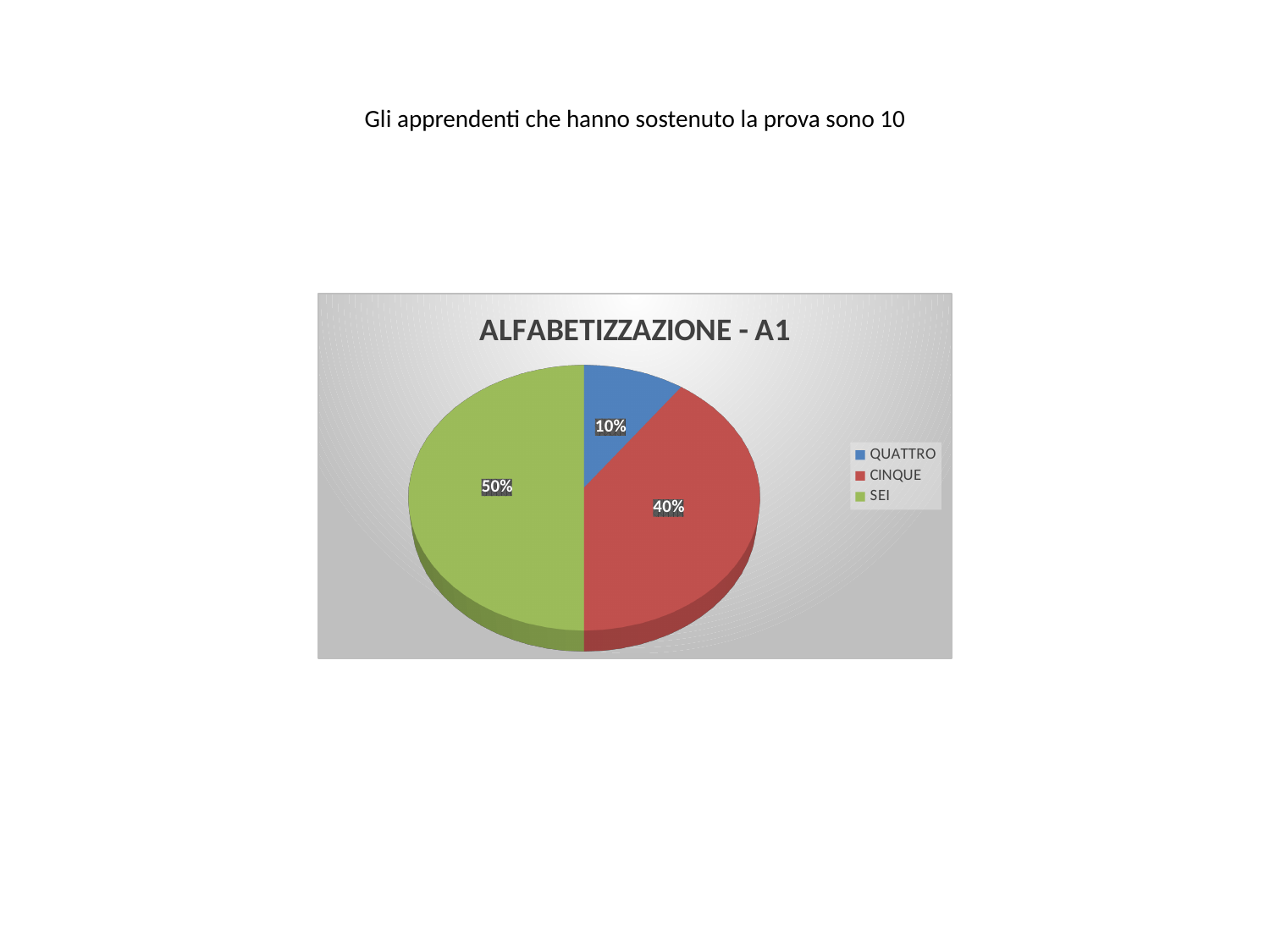
Which colour represents the CINQUE category in the legend? red What is the title of the chart? ALFABETIZZAZIONE - A1 How many categories does the pie chart have? 3 What share of the pie does the CINQUE slice represent? 40% Which category has the smallest slice of the pie? QUATTRO What kind of chart is shown on the slide? pie chart What share of the pie does the QUATTRO slice represent? 10% What is the difference in percentage points between the SEI slice and the QUATTRO slice? 40% What share of the pie does the SEI slice represent? 50% Which slice is larger, CINQUE or QUATTRO? CINQUE What is the difference in percentage points between the CINQUE slice and the QUATTRO slice? 30% Which category has the largest slice of the pie? SEI